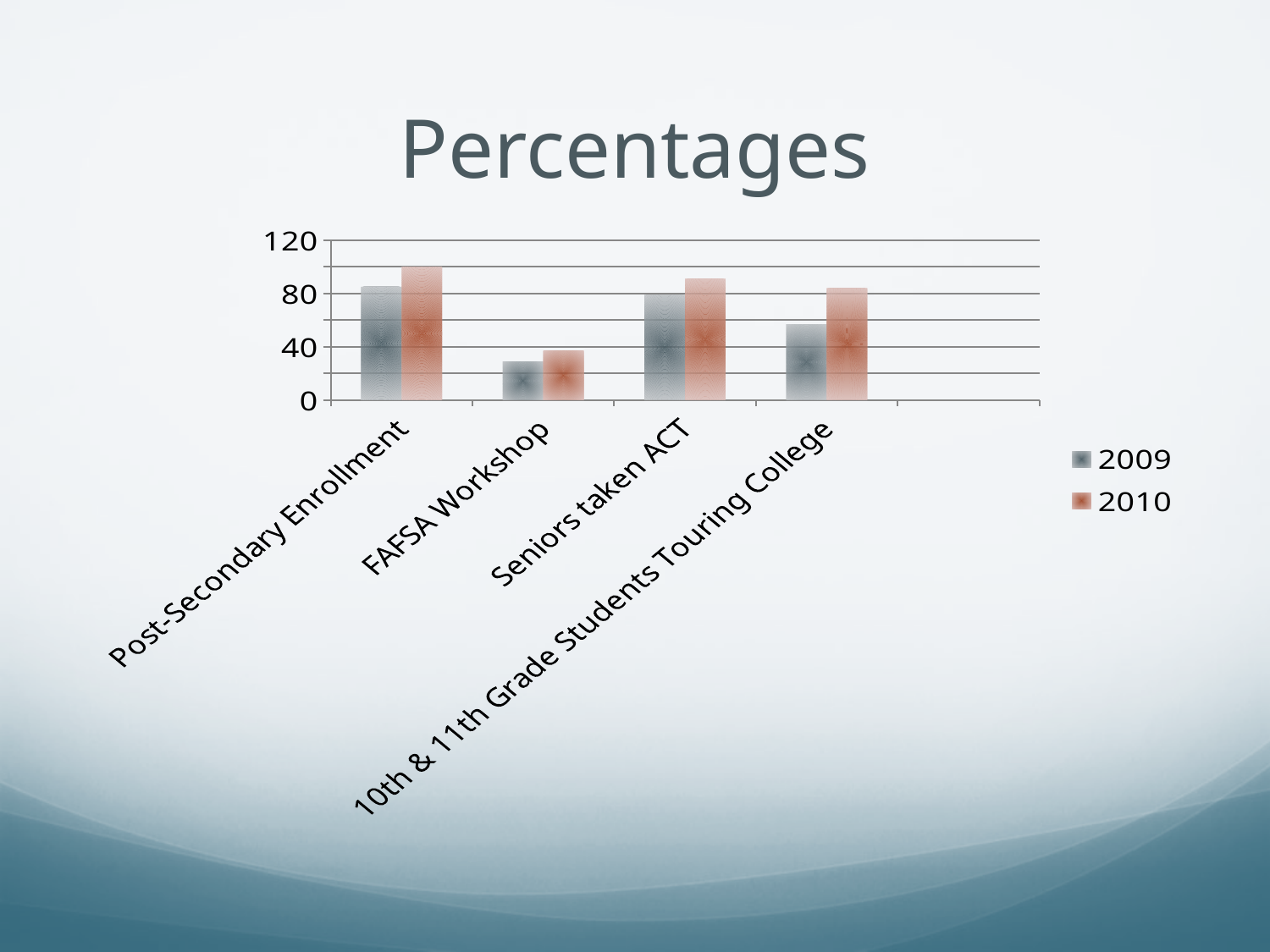
Which category has the lowest 2010 value? FAFSA Workshop What is the title of the chart? Percentages Which category has the lowest 2009 value? FAFSA Workshop Is the 2009 value for Post-Secondary Enrollment greater or less than 80? greater Which category has the highest 2010 value? Post-Secondary Enrollment Which is larger: the 2009 value for Seniors taken ACT or the 2009 value for FAFSA Workshop? Seniors taken ACT How many series does the legend list? 2 What kind of chart is shown on the slide? bar chart How many categories are shown on the x axis? 4 For 10th & 11th Grade Students Touring College, which series has the larger value, 2009 or 2010? 2010 Is the 2010 value for 10th & 11th Grade Students Touring College greater or less than 80? greater